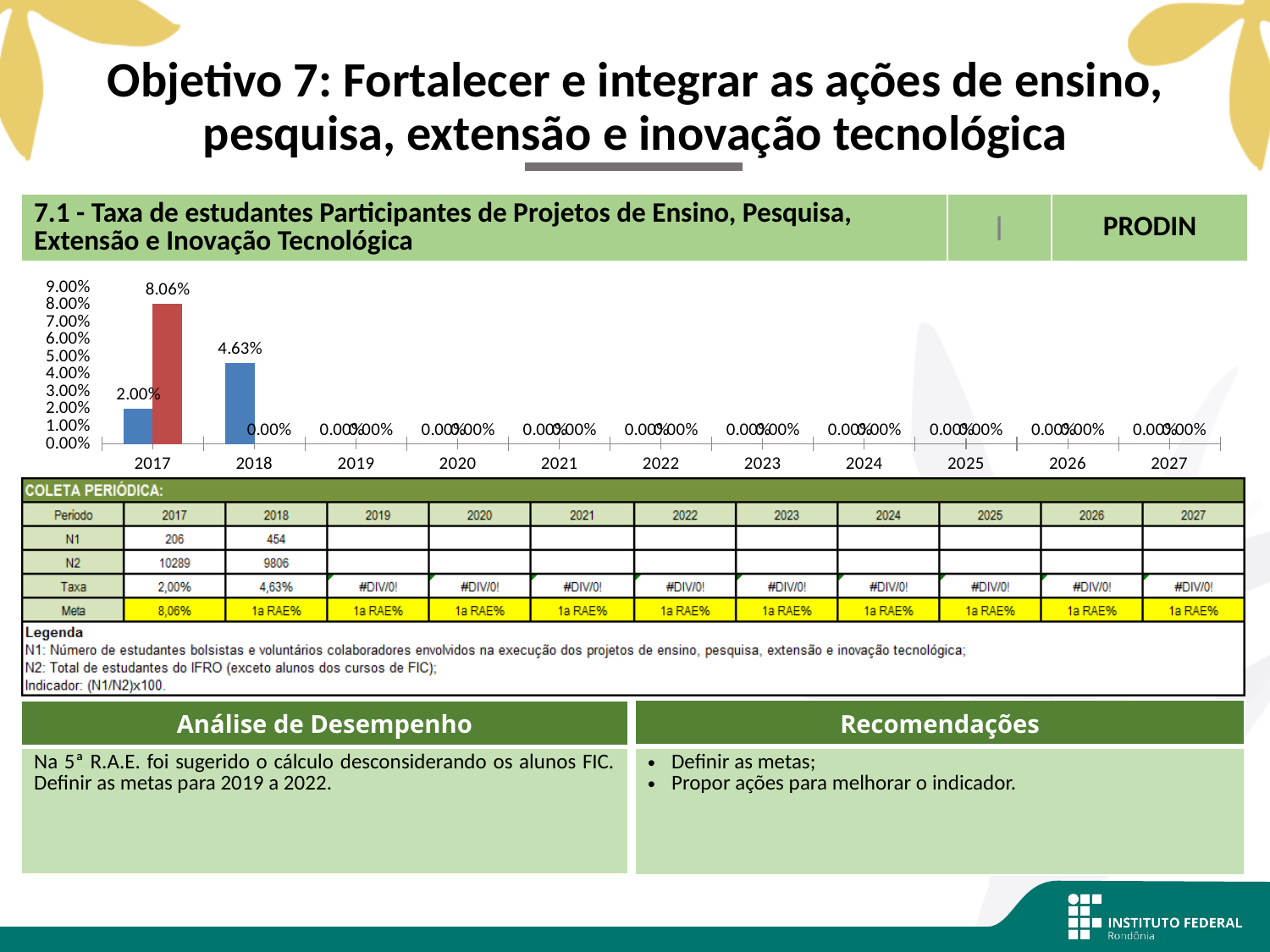
What kind of chart is shown on the slide? bar chart Is the red bar for 2017 greater or less than 8.00%? greater Which is larger, the blue bar for 2017 or the blue bar for 2018? 2018 How many years are shown on the x axis of the chart? 11 What is the difference between the blue bar for 2018 and the blue bar for 2017? 2.63% What is the highest value shown on the y axis of the chart? 9.00% What is the value of the blue bar for 2018? 4.63% What is the value of the red bar for 2018? 0.00% What is the value of the blue bar for 2017? 2.00% Which year has the tallest bar in the chart? 2017 What is the value of the red bar for 2017? 8.06% What is the difference between the red bar and the blue bar for 2017? 6.06%